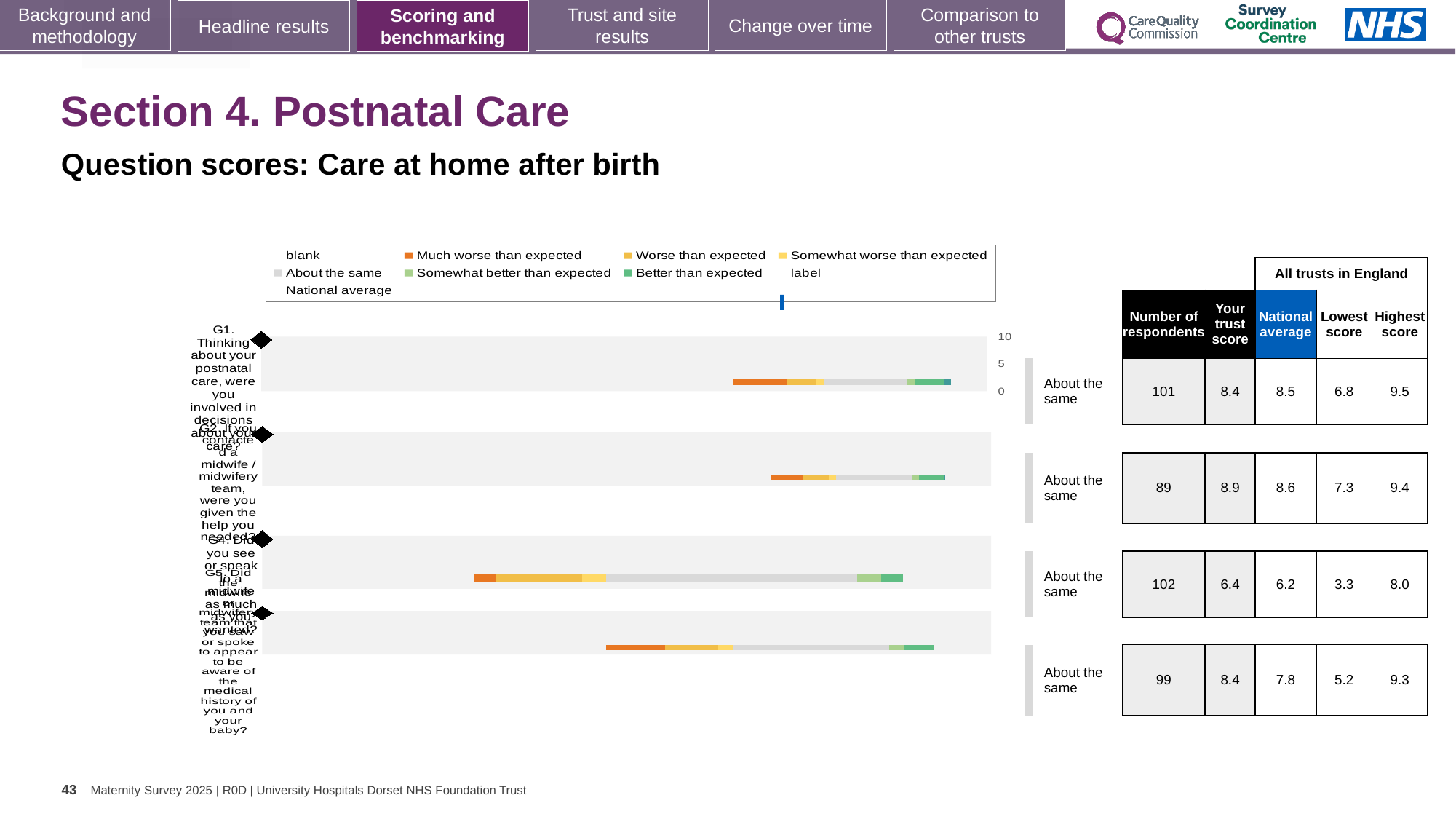
What is the difference between the trust score and the national average for G5? 0.6 In the table, what is the national average for G4 (see or speak to a midwife as much as you wanted)? 6.2 In the table, what is the number of respondents for G1 (involved in decisions about your care)? 101 In the table, what is the trust score for G2 (given the help you needed when contacting a midwife / midwifery team)? 8.9 Is the trust score for G2 larger or smaller than the national average for G2? larger Which question has the lowest trust score in the table? G4 What benchmark category is shown next to the bar for G1 (involved in decisions about your care)? About the same What kind of chart is shown on the slide? bar chart How many questions (bars) are plotted in the chart? 4 In the table, what is the highest score for G1 (involved in decisions about your care)? 9.5 In the table, what is the lowest score for G5 (midwife aware of the medical history of you and your baby)? 5.2 Which question has the highest number of respondents in the table? G4